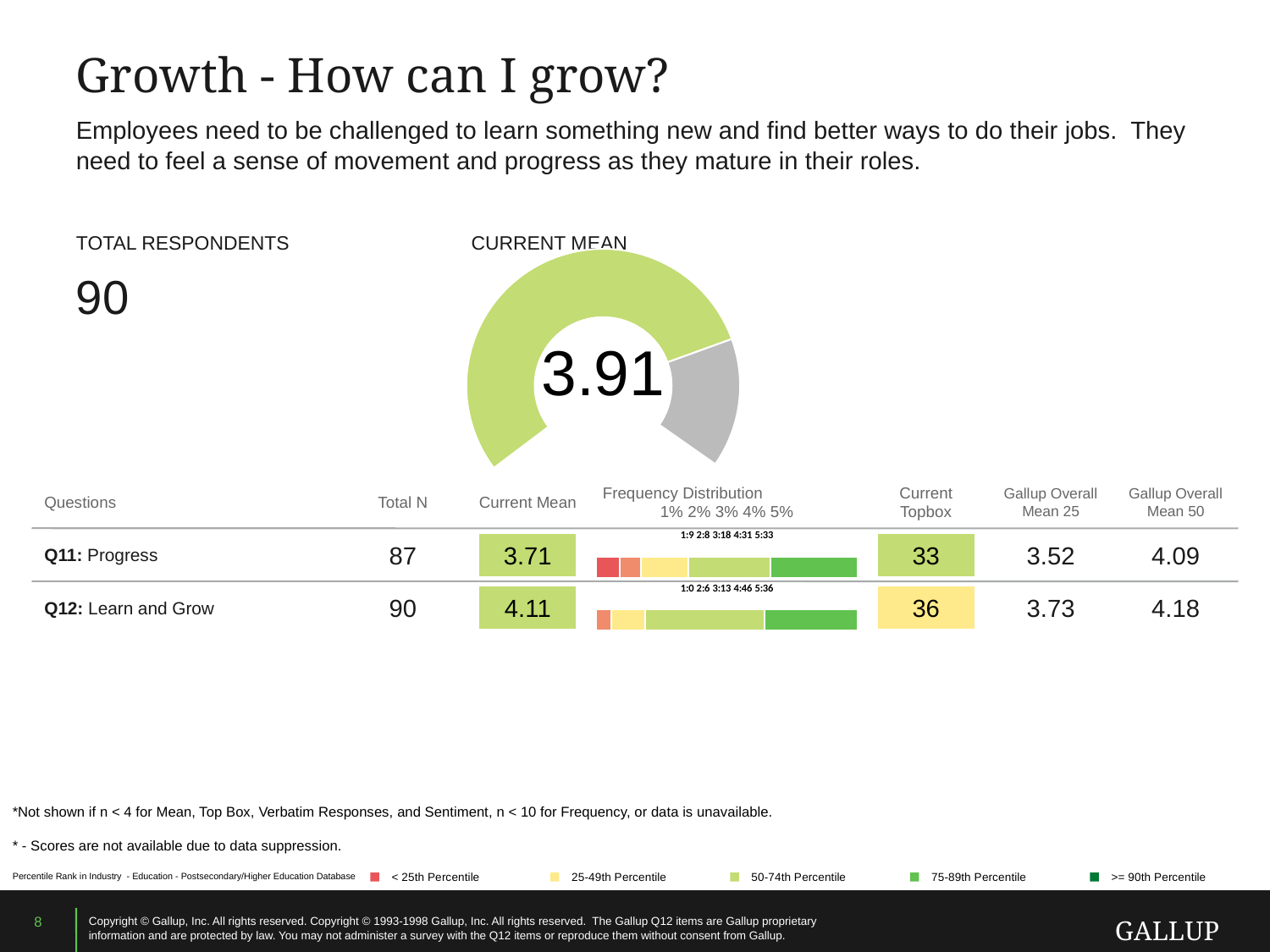
In the Frequency Distribution bar for Q11: Progress, what percentage is shown for response 5? 33 In the Frequency Distribution bar for Q11: Progress, which response value has the largest share? 5 How many response categories are labelled above the Frequency Distribution bar for Q11: Progress? 5 What value is shown in the centre of the Current Mean gauge chart? 3.91 What kind of chart is used to display the Current Mean? gauge chart In the Frequency Distribution bar for Q12: Learn and Grow, which response value has the largest share? 4 In the Frequency Distribution bar for Q12: Learn and Grow, what percentage is shown for response 4? 46 In the Frequency Distribution bar for Q11: Progress, what is the difference between the shares for response 5 and response 4? 2 Comparing the Frequency Distribution bars, which question has the larger share for response 3, Q11: Progress or Q12: Learn and Grow? Q11: Progress What is the total of the labelled values in the Frequency Distribution bar for Q12: Learn and Grow? 101 What colour is the filled portion of the Current Mean gauge chart? green In the Frequency Distribution bar for Q12: Learn and Grow, which response value has the smallest share? 1